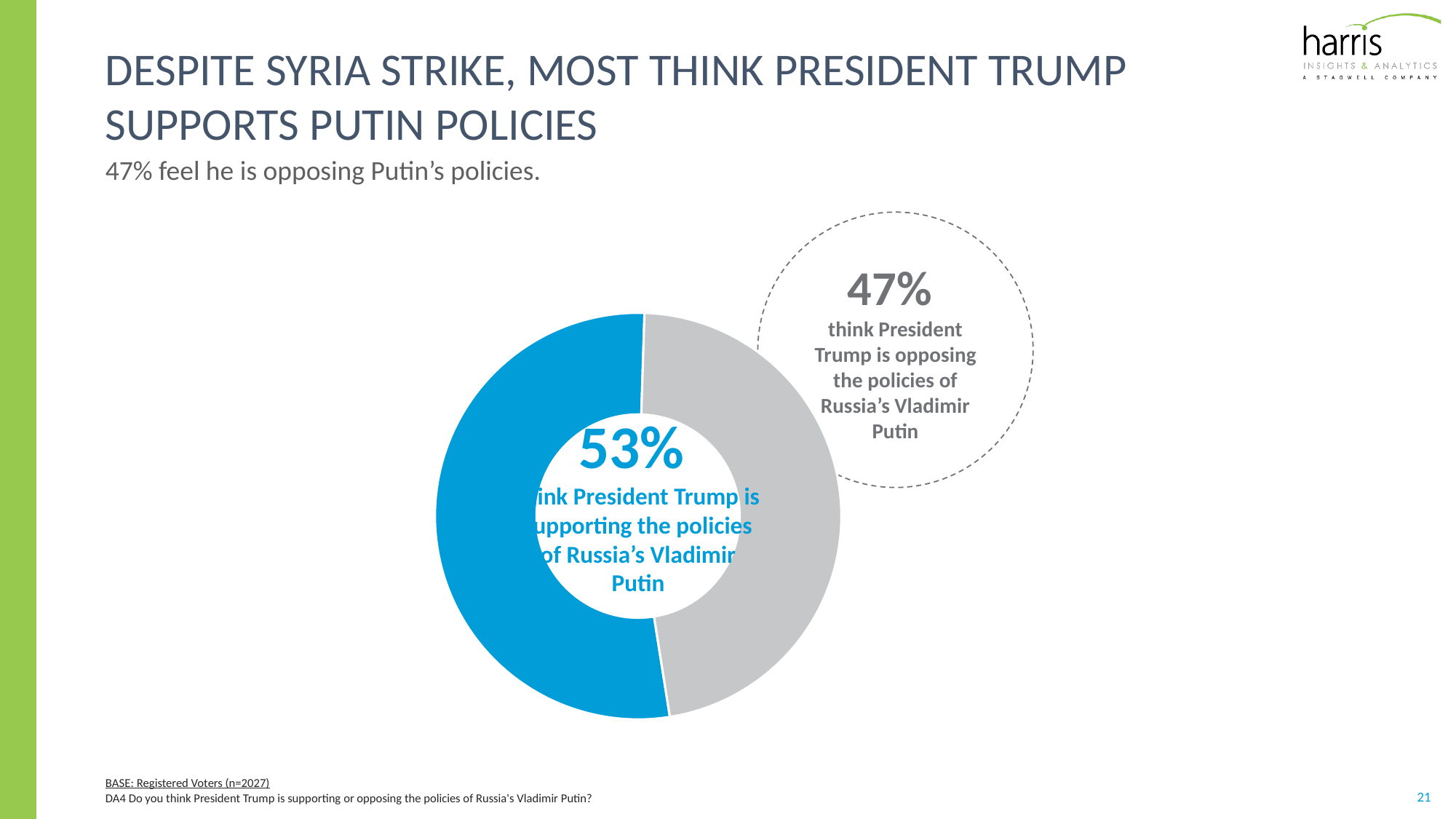
What kind of chart is shown on the slide? Pie chart (donut) What is the sample size (n) of registered voters stated in the base note? 2027 What is the difference in percentage points between those who think Trump is supporting Putin's policies and those who think he is opposing them? 6 What colour is the segment representing those who think Trump is supporting Putin's policies? Blue What is the total of the two segments shown in the chart? 100% Which view has the larger share: that Trump is supporting Putin's policies or that he is opposing them? Supporting What percentage think President Trump is supporting the policies of Russia's Vladimir Putin? 53% What percentage think President Trump is opposing the policies of Russia's Vladimir Putin? 47% Which view has the smaller share: that Trump is supporting Putin's policies or that he is opposing them? Opposing How many segments does the chart have? 2 Is the share who think Trump is supporting Putin's policies larger or smaller than the share who think he is opposing them? Larger Is the share who think Trump is opposing Putin's policies greater or less than 50%? less